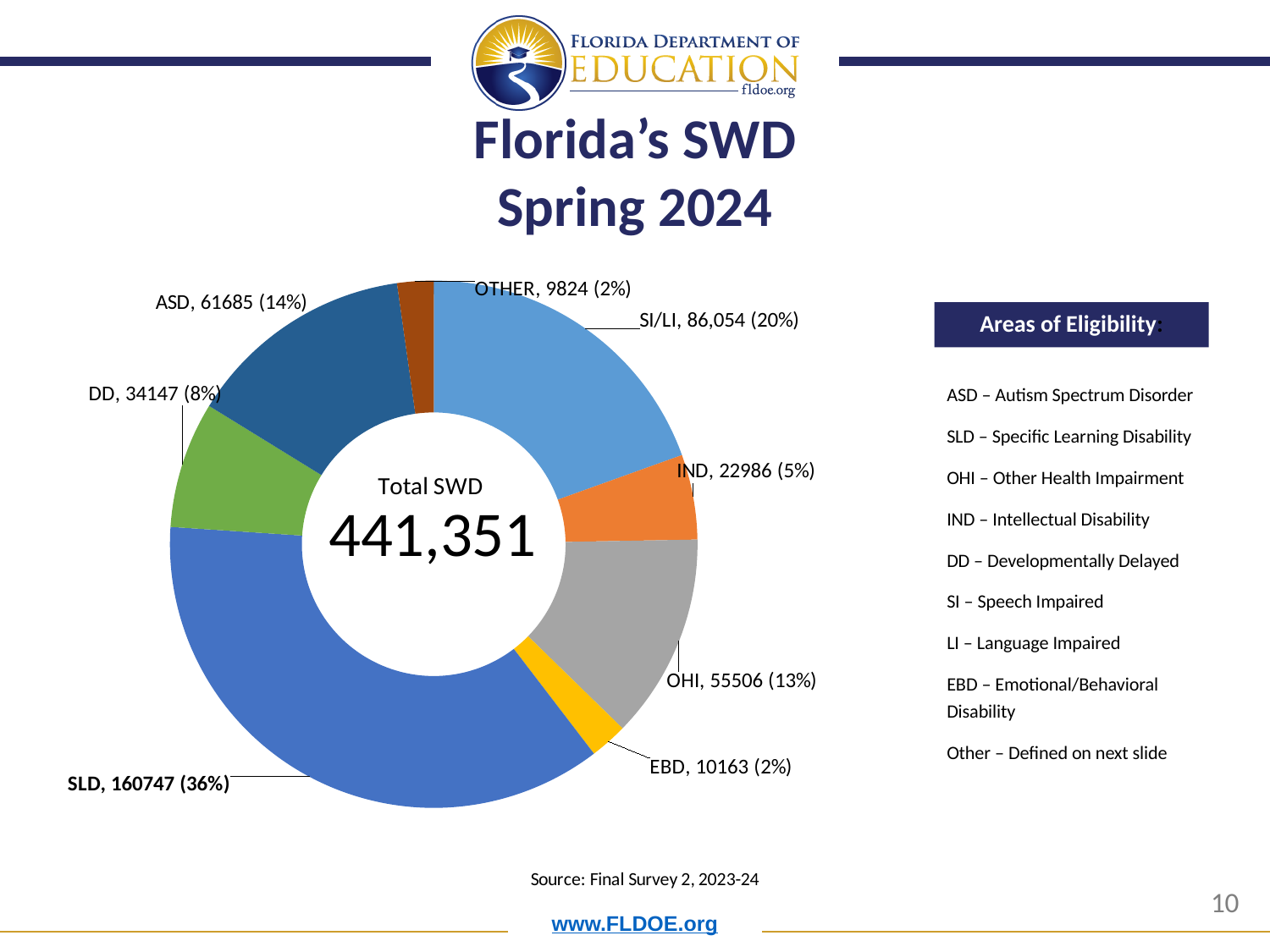
What is the difference between the OHI count and the IND count? 32520 What is the total SWD shown in the center of the chart? 441,351 What percentage of the total does ASD represent? 14% Which category has the largest share of the pie chart? SLD What is the value shown for SLD in the pie chart? 160747 (36%) Which is larger, the count for OHI or the count for DD? OHI Which category has the smallest count in the pie chart? OTHER What is the source cited below the chart? Final Survey 2, 2023-24 How many students are in the SI/LI category? 86,054 What kind of chart is shown on the slide? doughnut chart How many categories are shown in the pie chart? 8 What is the difference between the SLD count and the ASD count? 99062